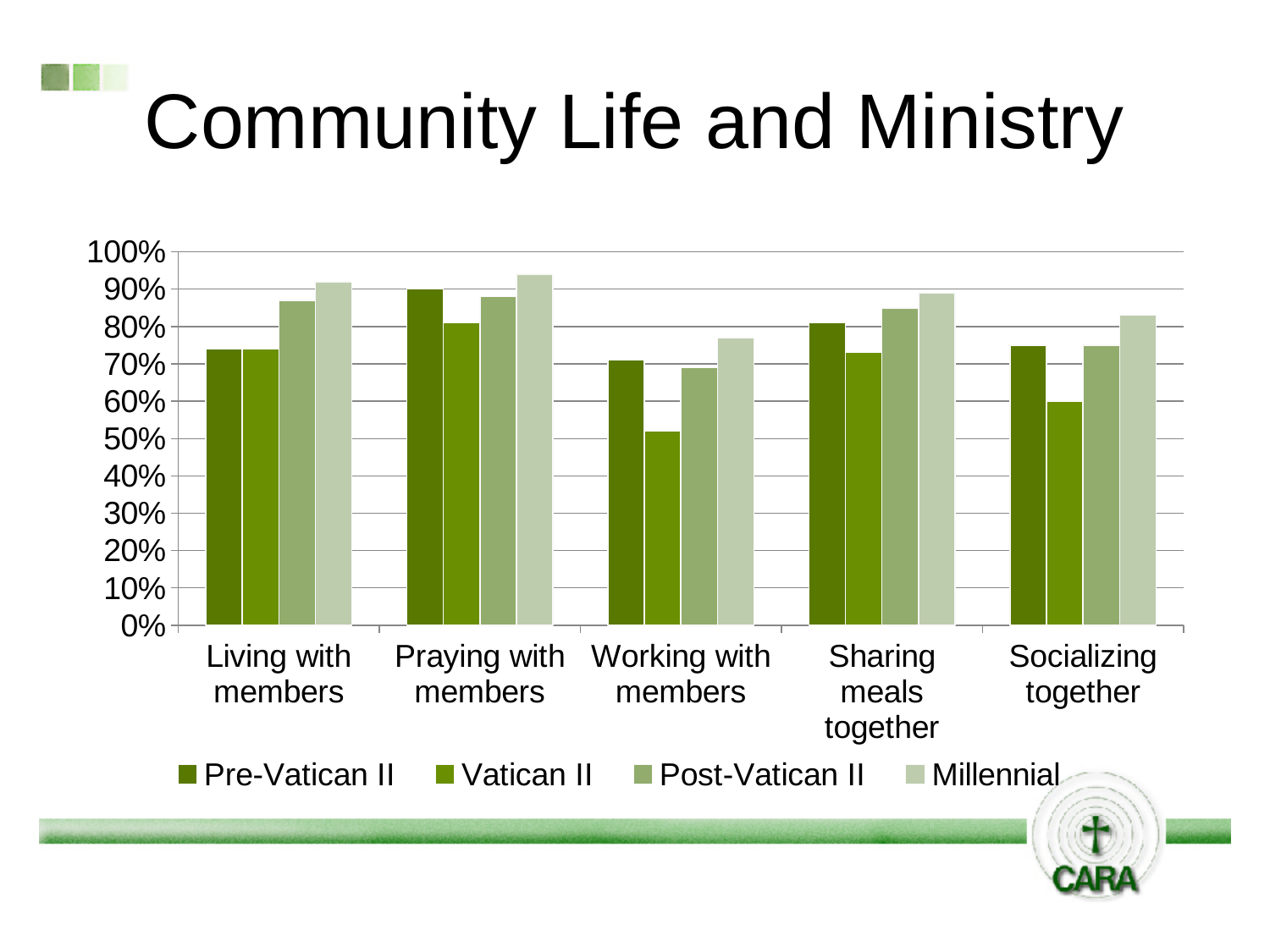
For which category is the Vatican II value lowest? Working with members Is the Millennial value for Praying with members greater or less than 90%? greater Is the Pre-Vatican II value for Praying with members greater or less than 80%? greater How many categories are shown on the x axis? 5 What is the title of the slide? Community Life and Ministry Is the Post-Vatican II value for Sharing meals together greater or less than 80%? greater How many series does the legend list? 4 Which series has the highest value for Working with members? Millennial For Socializing together, which is larger: the Vatican II value or the Millennial value? Millennial What kind of chart is shown on the slide? Bar chart Which series has the lowest value for Working with members? Vatican II